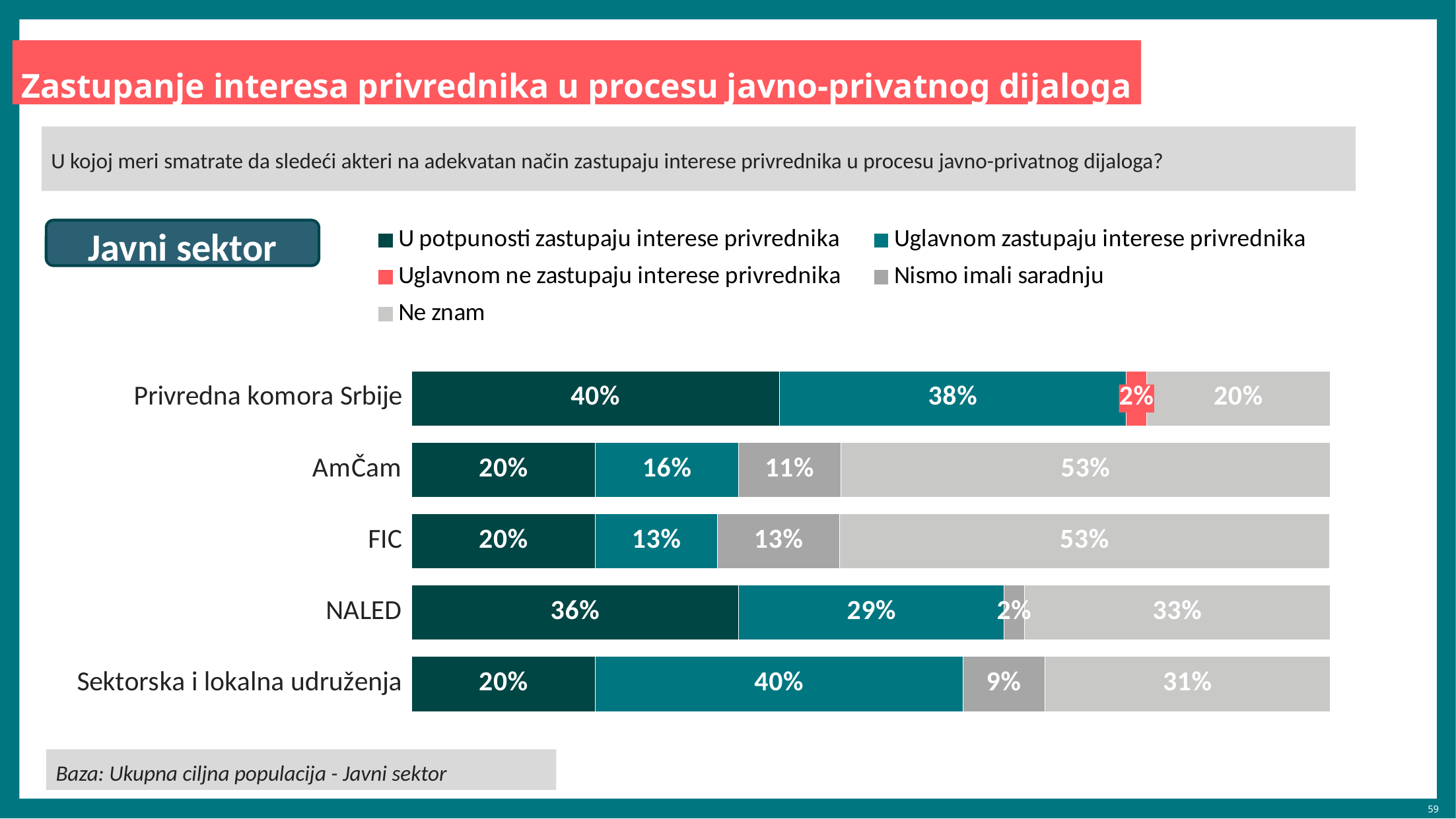
For NALED, what is the difference between the 'U potpunosti zastupaju' value and the 'Uglavnom zastupaju' value? 7 percentage points Which has a larger 'Ne znam' share: NALED or Sektorska i lokalna udruženja? NALED What is the 'Ne znam' value for AmČam? 53% Which actor has the highest 'U potpunosti zastupaju interese privrednika' share? Privredna komora Srbije How many actors (categories) are shown in the chart? 5 What is the title of the slide? Zastupanje interesa privrednika u procesu javno-privatnog dijaloga What type of chart is shown on the slide? Stacked bar chart What is the 'Uglavnom zastupaju interese privrednika' value for Sektorska i lokalna udruženja? 40% What percentage of respondents said Privredna komora Srbije 'U potpunosti zastupaju interese privrednika'? 40% What is the 'Nismo imali saradnju' value for FIC? 13% Which actor has the lowest 'Ne znam' share? Privredna komora Srbije How many series does the legend list? 5